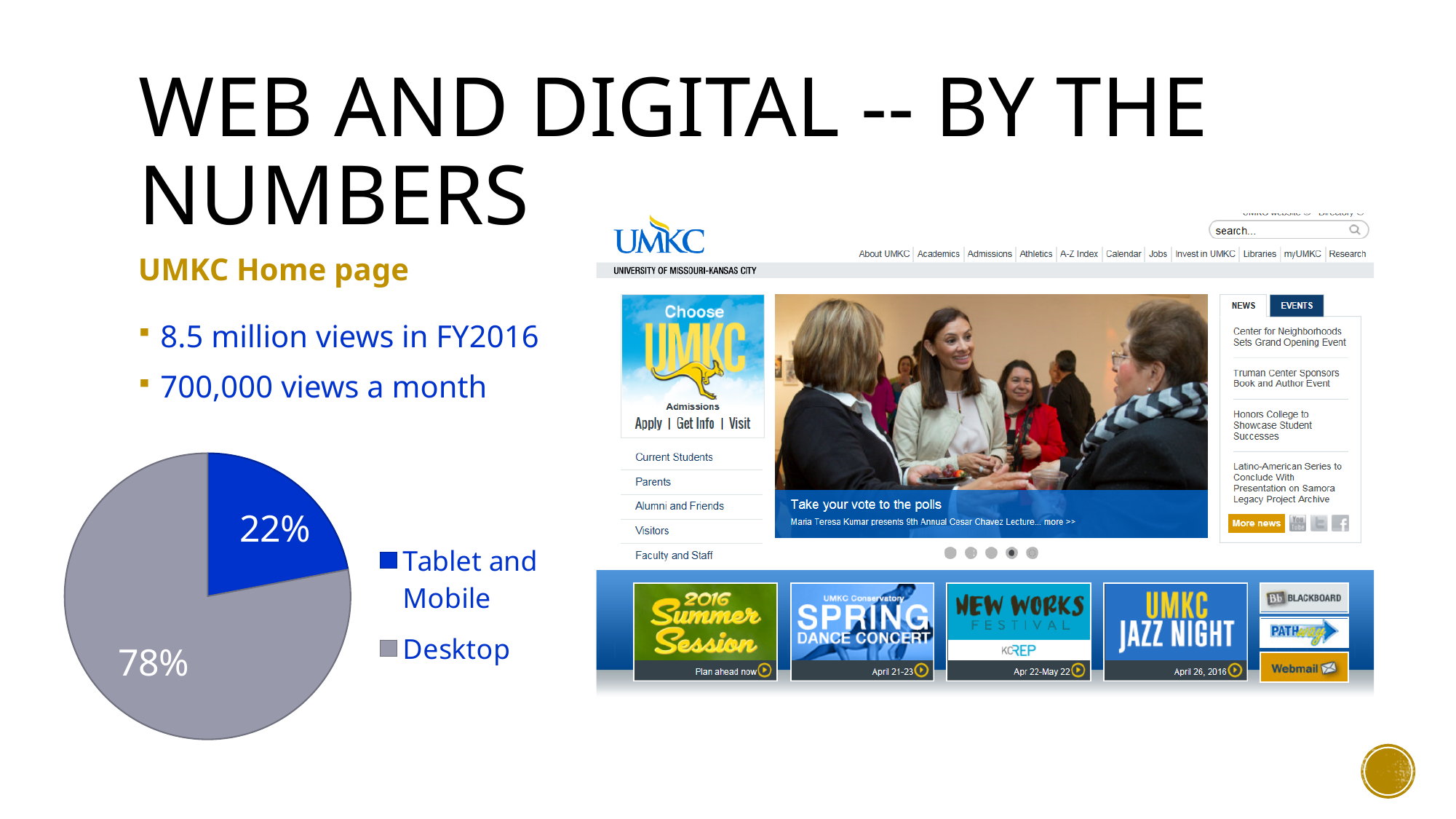
Which slice of the pie is the largest? Desktop What kind of chart is shown on the slide? pie chart What colour is the Desktop slice in the pie chart? grey Which slice of the pie is the smallest? Tablet and Mobile Which is larger, the Desktop slice or the Tablet and Mobile slice? Desktop How many slices does the pie chart have? 2 What share of the pie does Tablet and Mobile represent? 22% What share of the pie does Desktop represent? 78% What colour is the Tablet and Mobile slice in the pie chart? blue What is the difference in percentage points between the Desktop and Tablet and Mobile slices? 56 How many entries does the legend of the pie chart list? 2